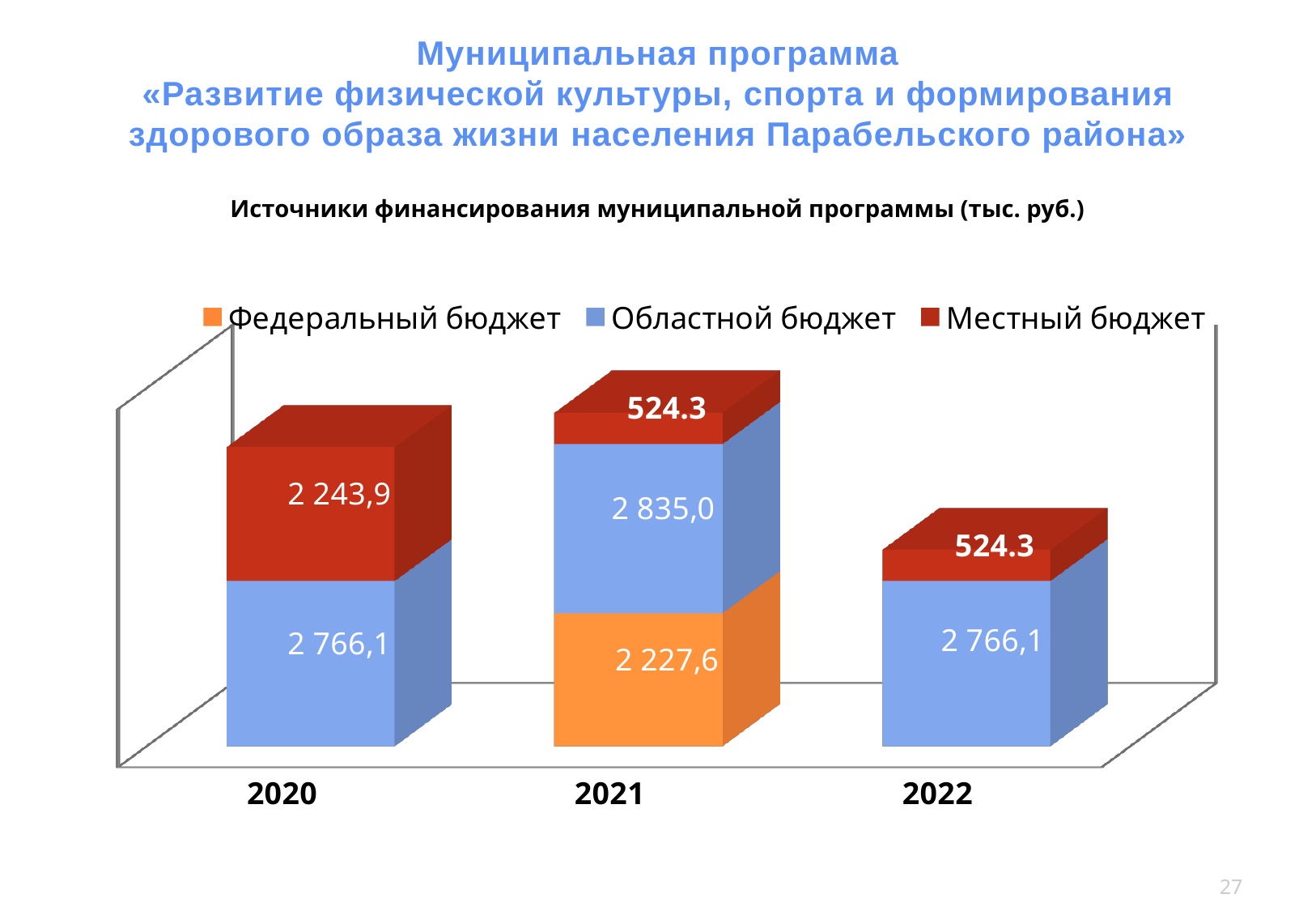
What type of chart is shown on the slide? Stacked bar chart What is the value of Местный бюджет for 2020? 2 243,9 What is the value of Федеральный бюджет for 2021? 2 227,6 In which year is the Областной бюджет value highest? 2021 What is the difference between Местный бюджет in 2020 and in 2021? 1 719,6 How many series does the legend list? 3 How many years (categories) are shown on the x axis? 3 In which year is the Местный бюджет value highest? 2020 What is the total of the stacked bar for 2022? 3 290,4 Which is larger: Областной бюджет in 2020 or Местный бюджет in 2020? Областной бюджет in 2020 What is the value of Областной бюджет for 2021? 2 835,0 What is the value of Местный бюджет for 2022? 524.3